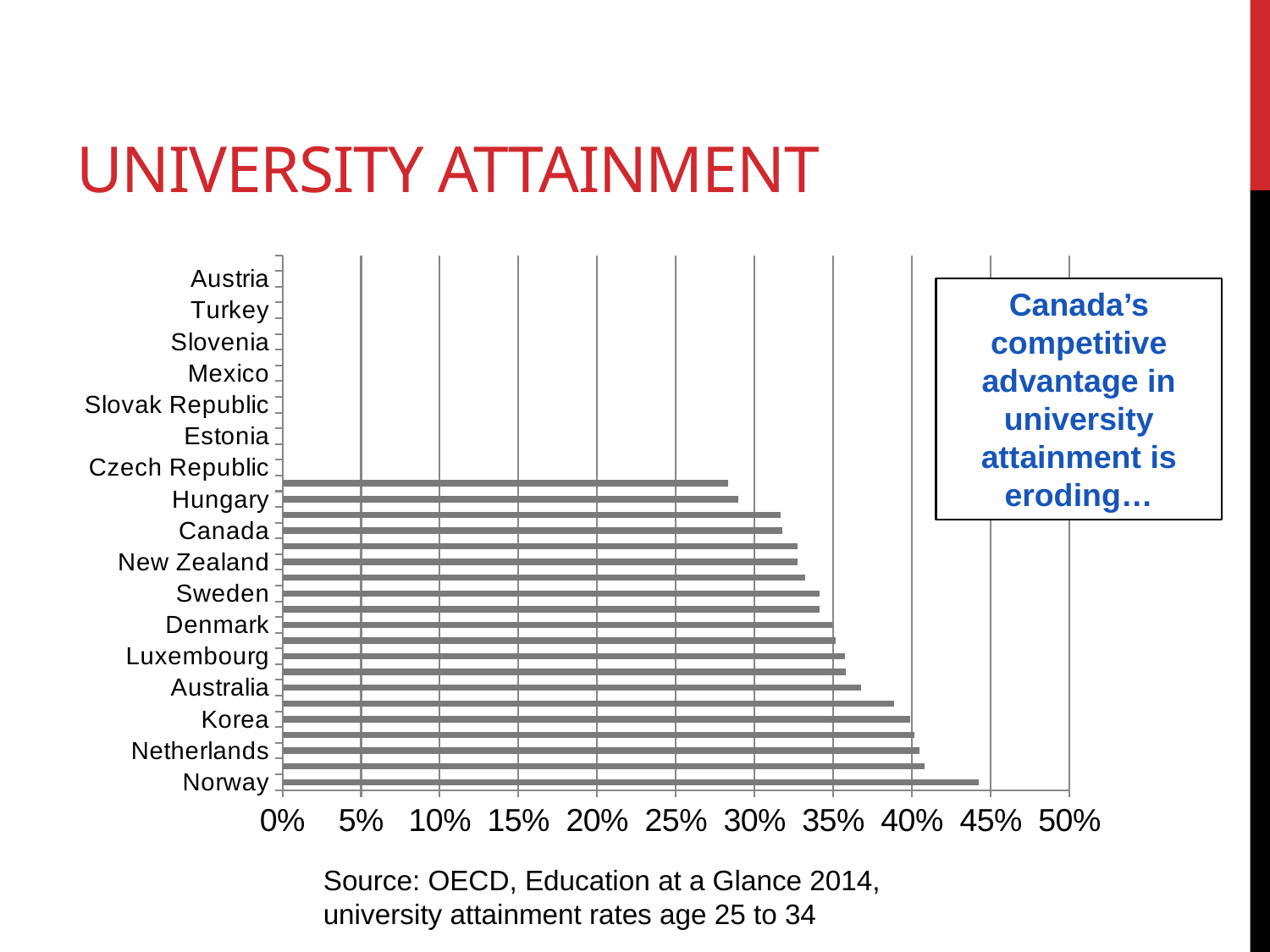
Which has the larger value, Norway or Canada? Norway Is the value for Canada greater or less than 35%? less Is the value for Norway greater or less than 40%? greater Is the value for Canada greater or less than 30%? greater Which has the larger value, Australia or Canada? Australia Which country has the highest university attainment rate in the chart? Norway What is the title of the chart on the slide? UNIVERSITY ATTAINMENT Which has the larger value, Canada or Hungary? Canada What is the highest value shown on the horizontal axis of the chart? 50% What kind of chart is shown on the slide? Bar chart